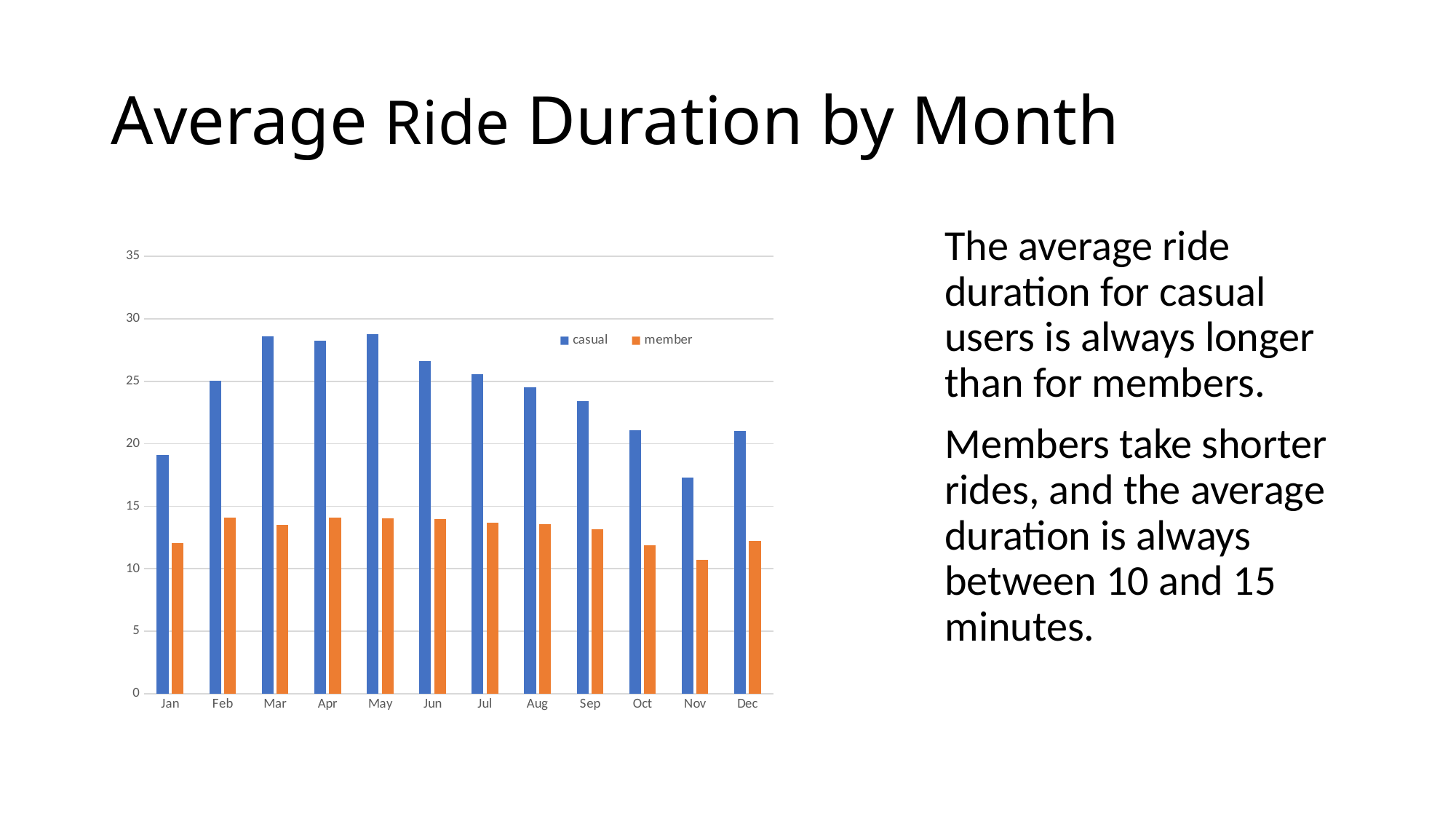
Which month has the lowest casual average ride duration? Nov Do the casual values rise or fall from May to Nov? Fall Which month has the lowest member average ride duration? Nov Is the member value for Nov greater or less than 10? greater How many months are shown on the x axis of the chart? 12 Is the member value for Feb greater or less than 15? less Is the casual value for Mar greater or less than 25? greater Which colour represents the member series in the chart? Orange What kind of chart is shown on the slide? Bar chart Which is larger, the casual value for Feb or the casual value for Nov? Feb How many series does the chart legend list? 2